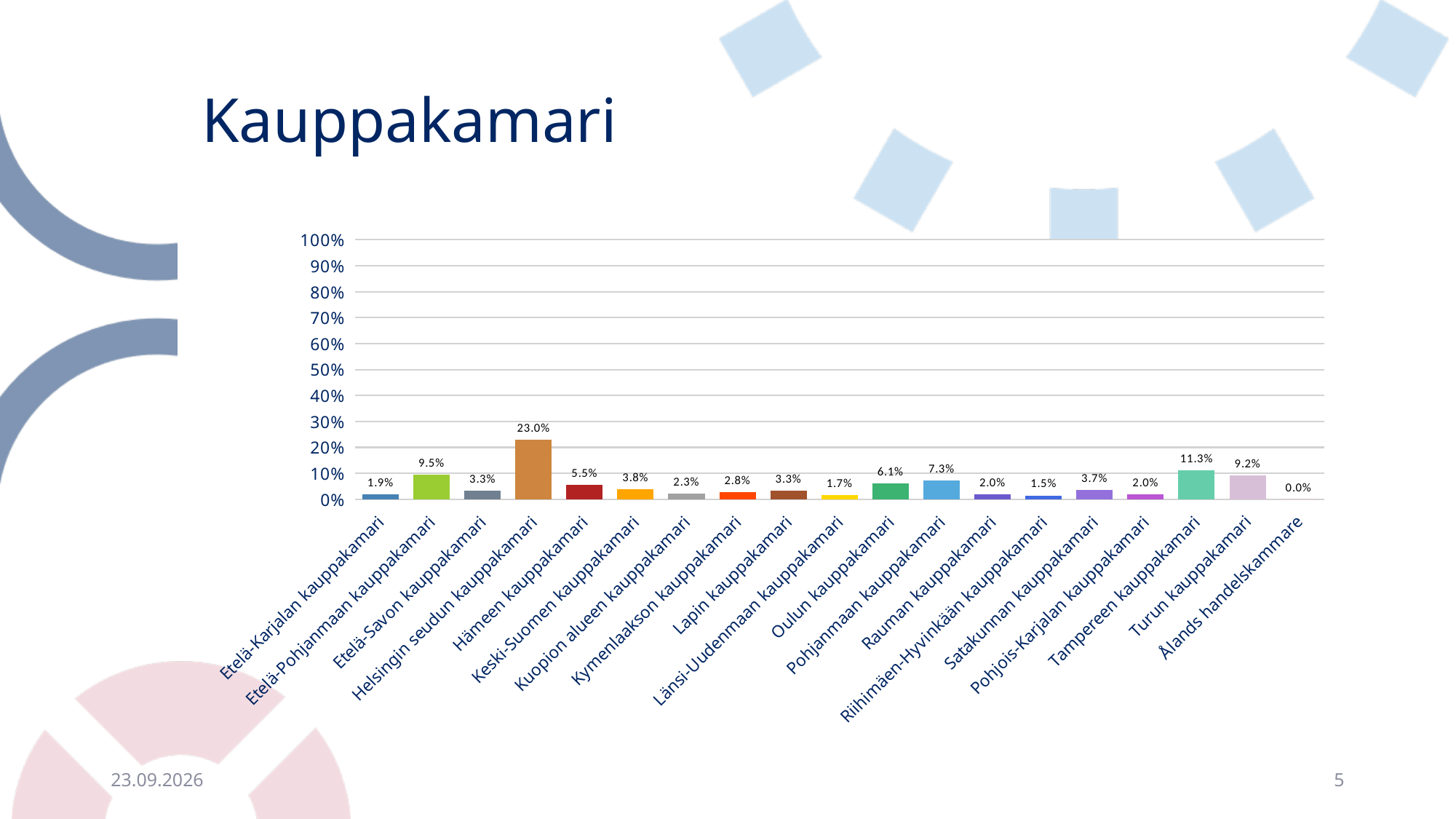
Which category has the lowest value? Ålands handelskammare Is the value for Helsingin seudun kauppakamari greater or less than 20%? greater What is the value for Riihimäen-Hyvinkään kauppakamari? 1.5% What kind of chart is shown on the slide? bar chart How many categories are shown on the x axis? 19 What is the difference between the values for Etelä-Pohjanmaan kauppakamari and Turun kauppakamari? 0.3% What is the value for Ålands handelskammare? 0.0% What is the value for Tampereen kauppakamari? 11.3% What is the value for Helsingin seudun kauppakamari? 23.0% Which category has the highest value? Helsingin seudun kauppakamari Which is larger, the value for Oulun kauppakamari or the value for Pohjanmaan kauppakamari? Pohjanmaan kauppakamari What is the difference between the values for Helsingin seudun kauppakamari and Tampereen kauppakamari? 11.7%